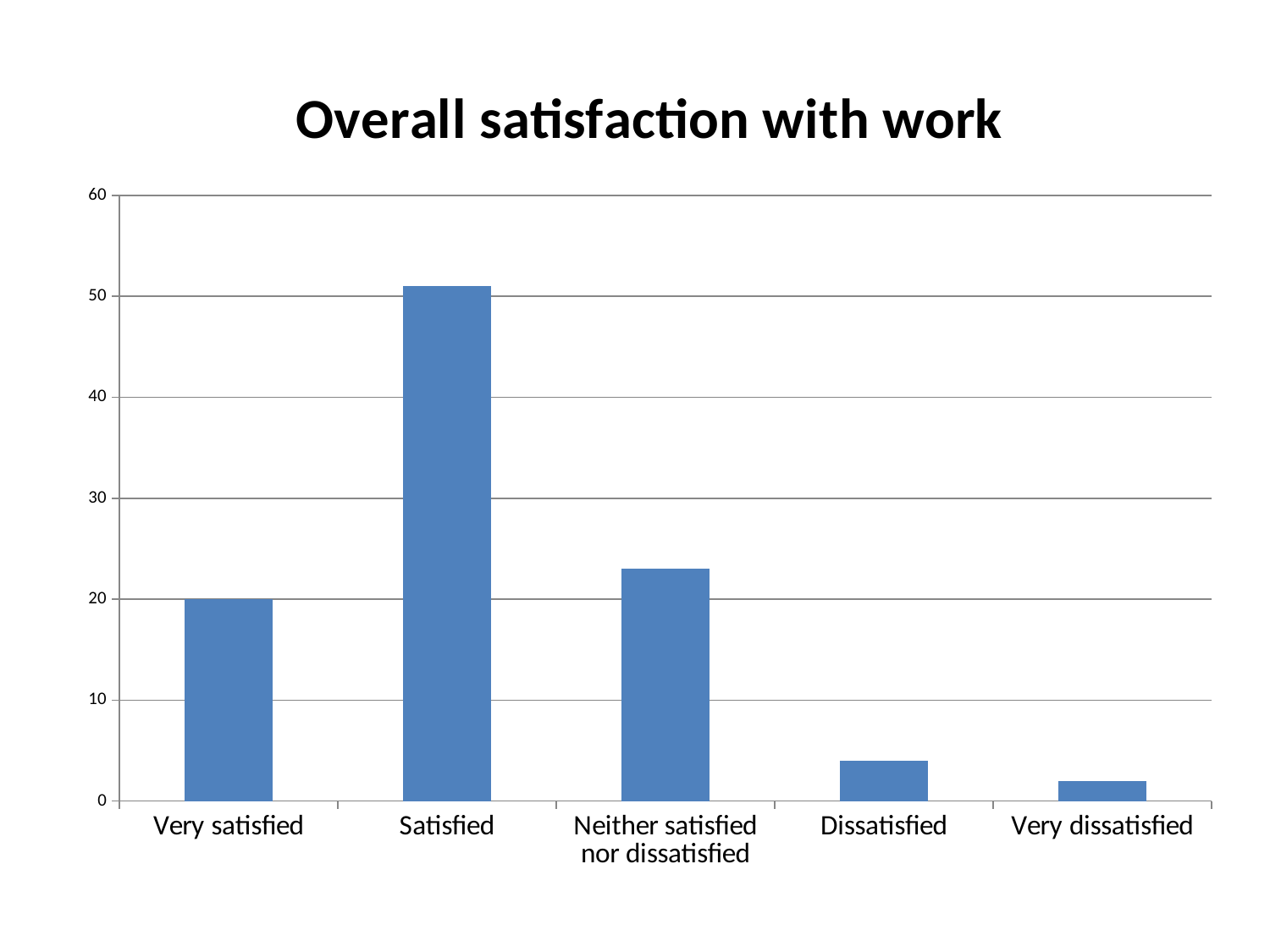
Which is larger, the value for Dissatisfied or the value for Very dissatisfied? Dissatisfied What is the title of the chart? Overall satisfaction with work Which category has the highest value? Satisfied Is the value for Neither satisfied nor dissatisfied greater or less than 30? less Is the value for Satisfied greater or less than 50? greater Which category has the lowest value? Very dissatisfied What is the value for Very satisfied? 20 What is the highest value shown on the vertical axis? 60 What kind of chart is shown on the slide? bar chart Which is larger, the value for Very satisfied or the value for Neither satisfied nor dissatisfied? Neither satisfied nor dissatisfied How many categories are shown on the x axis? 5 Is the value for Dissatisfied greater or less than 10? less